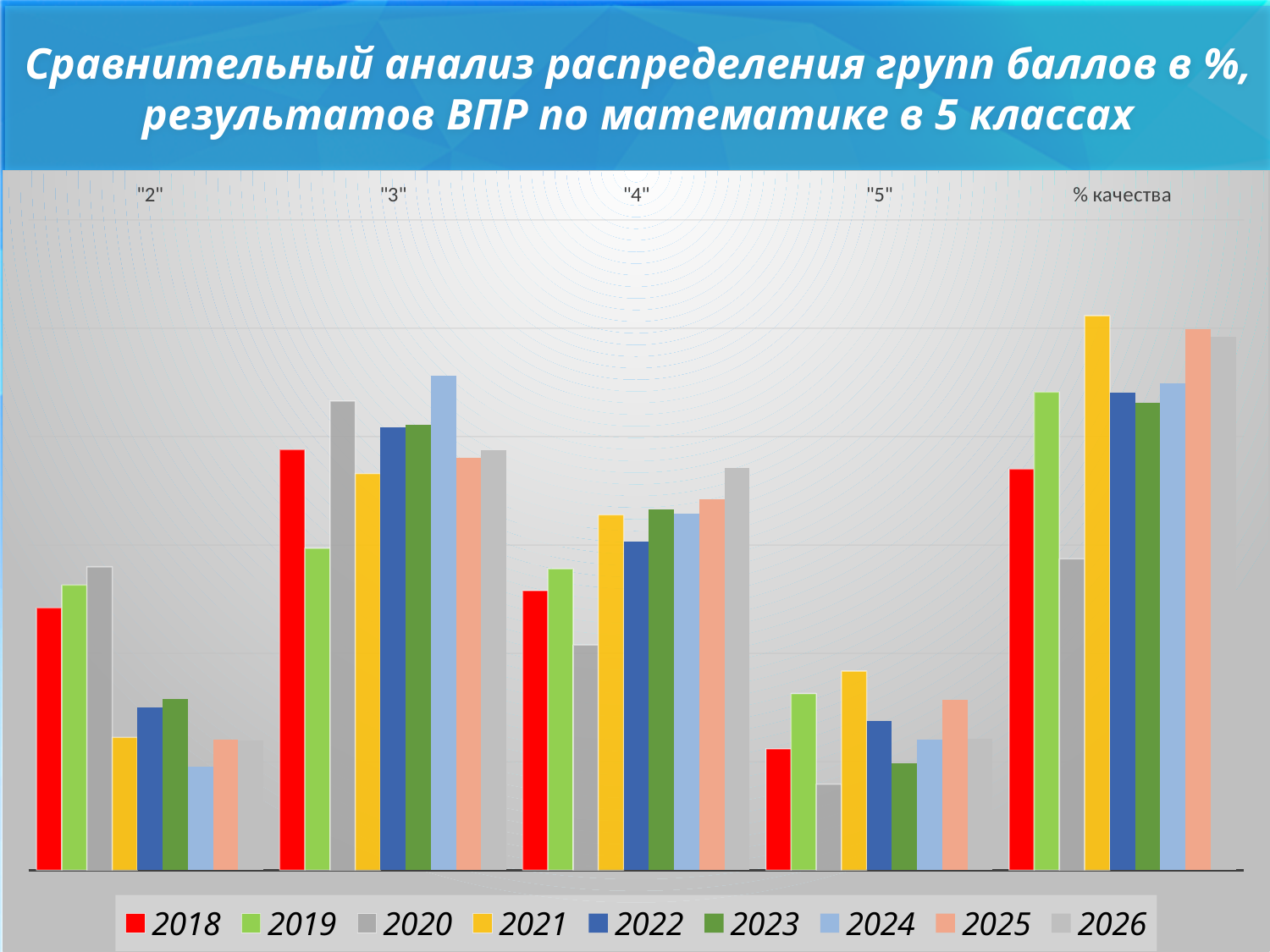
In the "5" category, which year has the highest bar? 2021 In the "% качества" category, which is larger: the value for 2019 or the value for 2020? 2019 In the "2" category, which year has the lowest bar? 2024 How many series does the chart's legend list? 9 Which year is listed first in the chart's legend? 2018 In the "4" category, which year has the lowest bar? 2020 In the "% качества" category, which year has the highest bar? 2021 How many categories are shown along the x axis of the chart? 5 In the "2" category, which year has the highest bar? 2020 What kind of chart is shown on the slide? bar chart In the "3" category, which year has the lowest bar? 2019